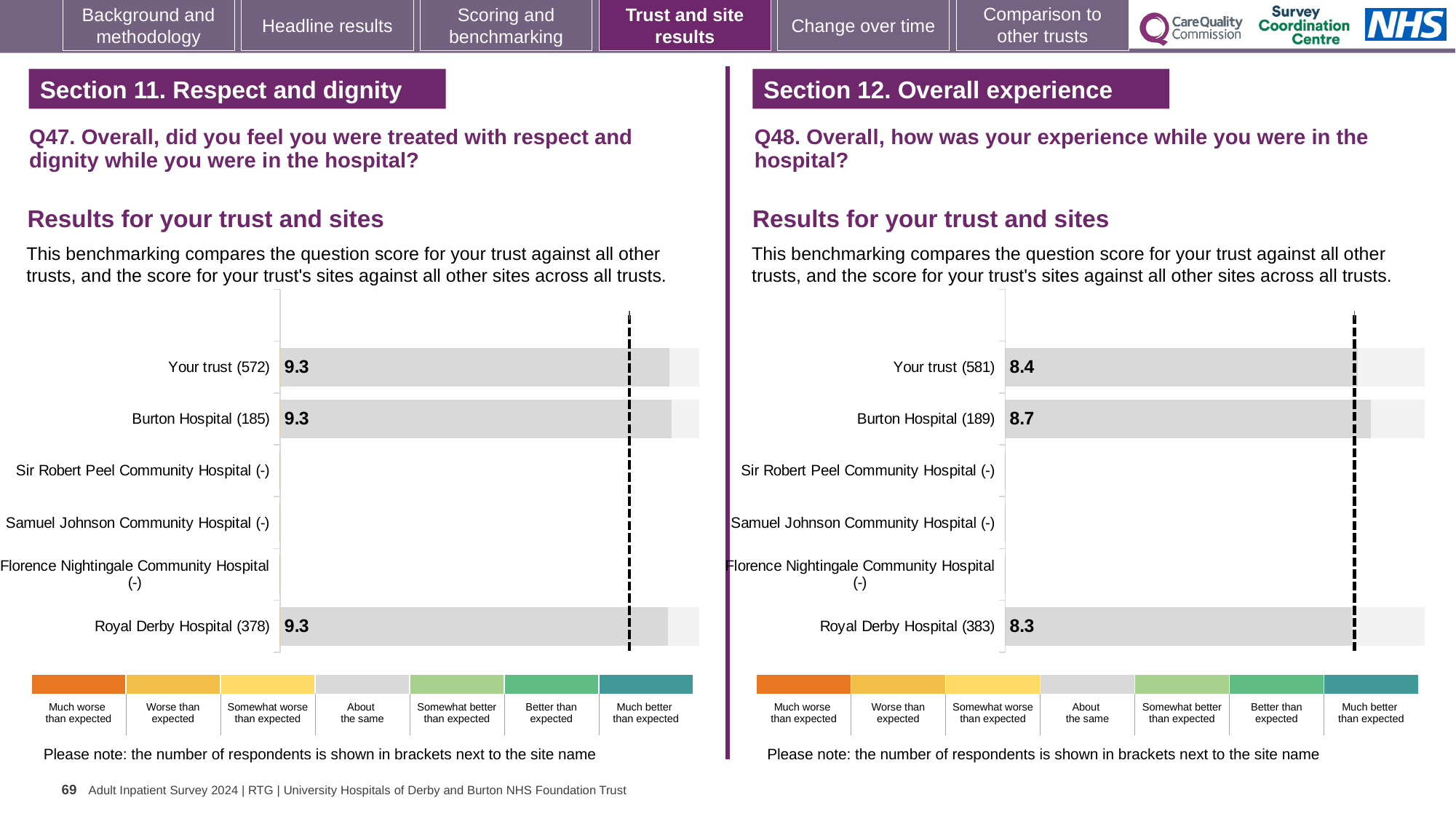
On the Q48 chart (right), what is the difference between the Burton Hospital score and the Royal Derby Hospital score? 0.4 On the Q48 chart (right), which is larger: the score for Burton Hospital or the score for Your trust? Burton Hospital How many site rows (including Your trust) are listed on the Q47 chart (left)? 6 On the Q48 chart (right), what is the score for Royal Derby Hospital? 8.3 On the Q48 chart (right), what is the score for Burton Hospital? 8.7 On the Q47 chart (left), how many respondents are shown in brackets for Your trust? 572 On the Q47 chart (left), what is the score for Your trust? 9.3 On the Q48 chart (right), what is the score for Your trust? 8.4 On the Q48 chart (right), which site has the highest score? Burton Hospital On the Q47 chart (left), what is the score for Royal Derby Hospital? 9.3 On the Q48 chart (right), which site has the lowest score? Royal Derby Hospital What type of chart is used on the Q47 chart (left)? Bar chart